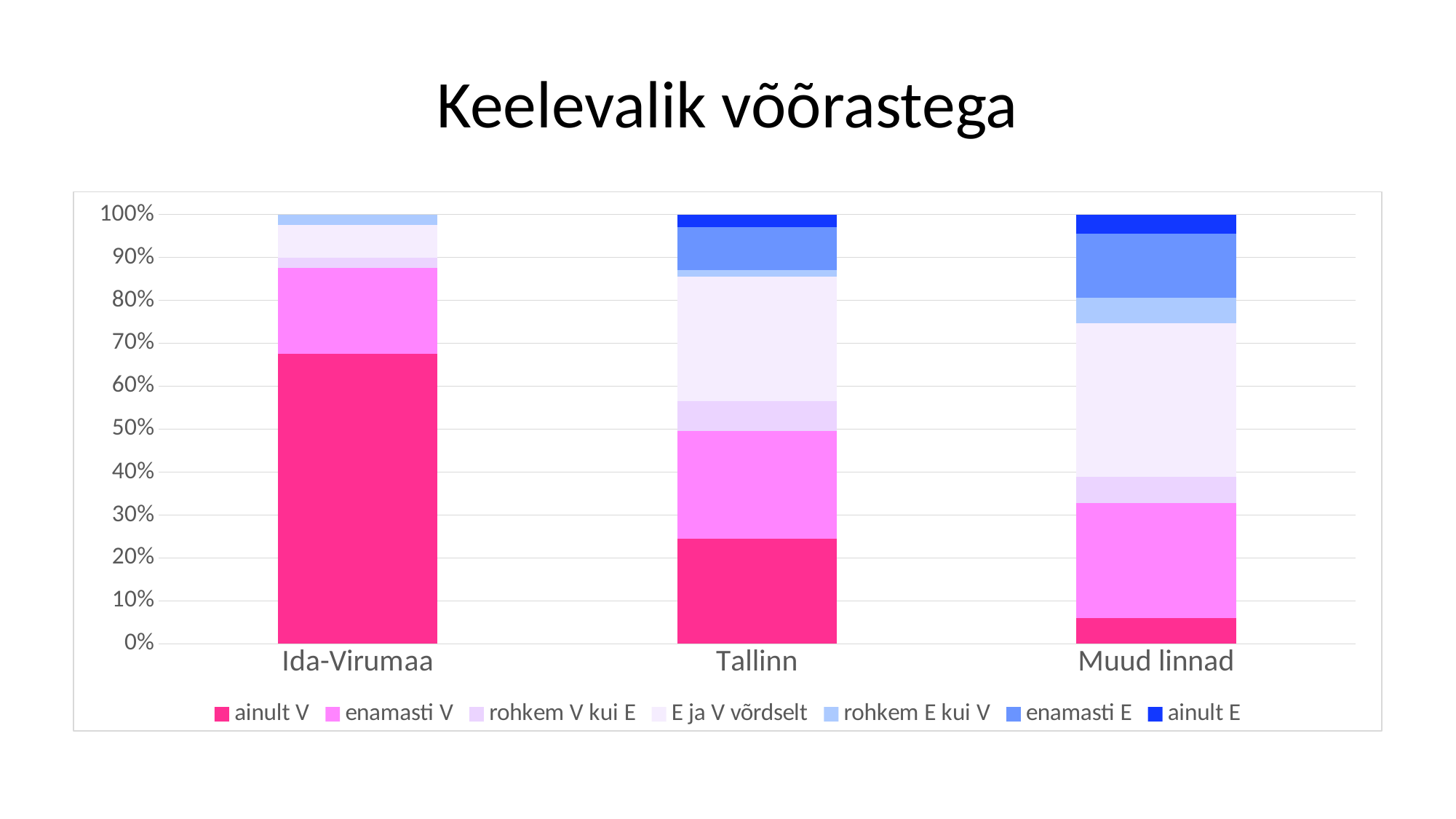
Which category has the smallest share of 'ainult V'? Muud linnad Which category has the largest share of 'E ja V võrdselt'? Muud linnad Which has a larger 'ainult V' share, Ida-Virumaa or Tallinn? Ida-Virumaa Is the 'ainult V' share for Tallinn greater or less than 30%? less Is the 'ainult V' share for Ida-Virumaa greater or less than 60%? greater Is the 'ainult V' share for Muud linnad greater or less than 10%? less How many categories are shown on the x axis? 3 How many series does the legend list? 7 What is the title of the chart? Keelevalik võõrastega What is the total of the Tallinn stacked bar? 100% What kind of chart is shown on the slide? Stacked bar chart Which category has the largest share of 'ainult V'? Ida-Virumaa